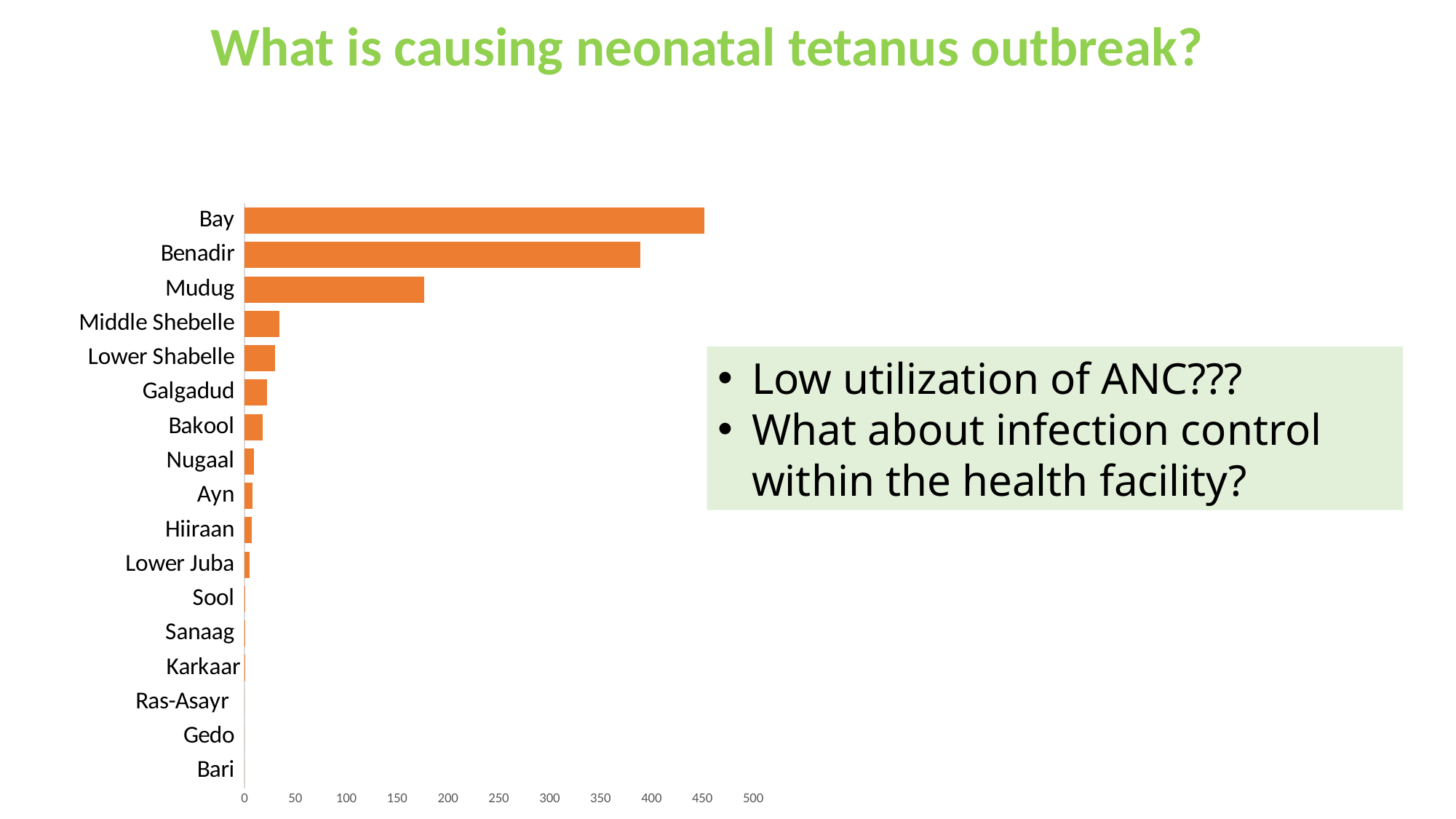
Is the value for Benadir greater or less than 350? greater Which region has the highest value on the chart? Bay Which region has the larger value, Bay or Benadir? Bay Is the value for Middle Shebelle greater or less than 50? less What colour are the bars in the chart? Orange How many regions are listed on the chart's vertical axis? 17 Is the value for Benadir greater or less than 400? less What kind of chart is shown on the slide? Bar chart Do the bar values increase or decrease going from the top region (Bay) to the bottom region (Bari)? Decrease Which region has the larger value, Mudug or Middle Shebelle? Mudug